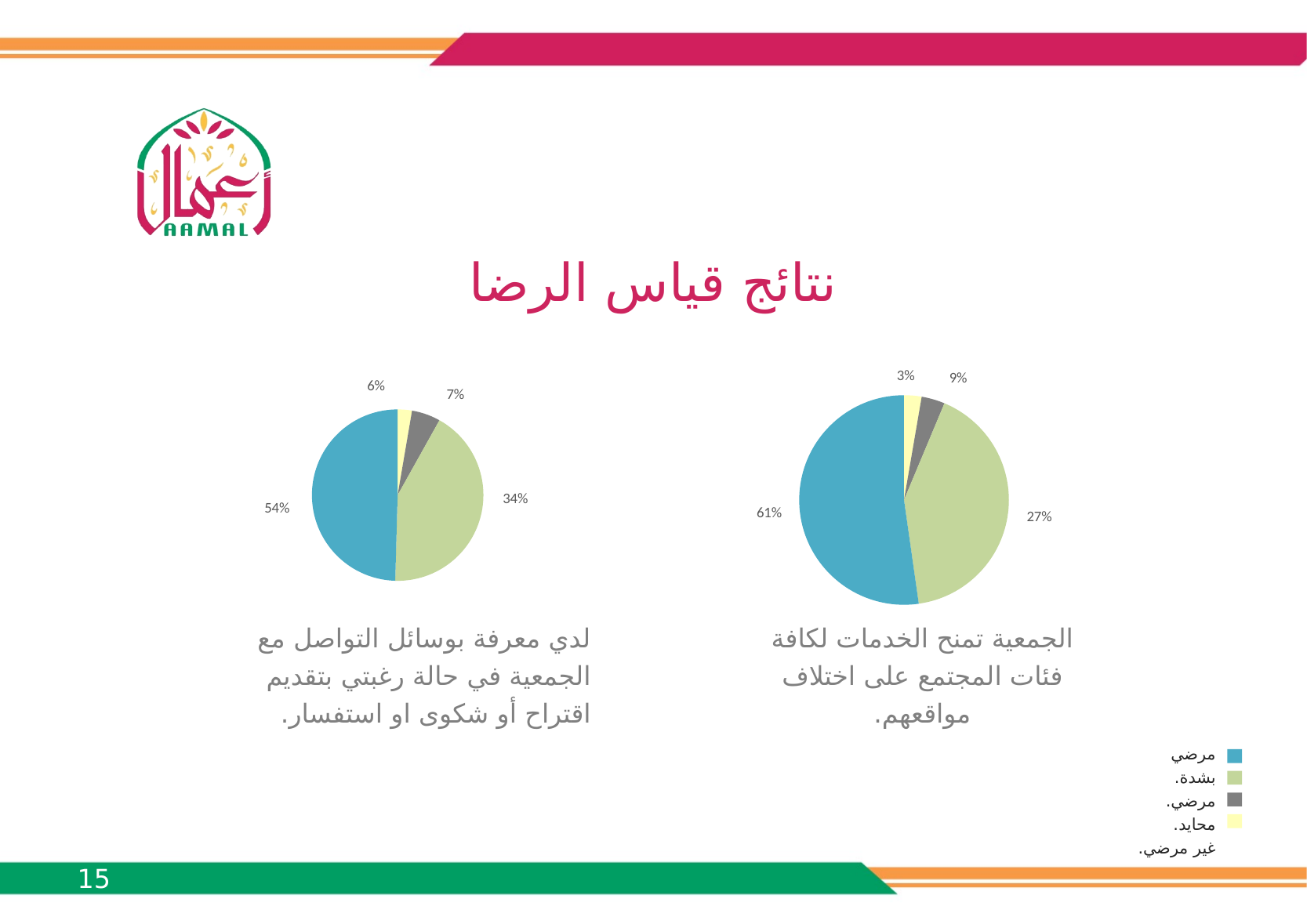
In the left pie chart (لدي معرفة بوسائل التواصل مع الجمعية), what is the largest slice's percentage? 54% In the right pie chart (الجمعية تمنح الخدمات لكافة فئات المجتمع), what percentage does the blue slice represent? 61% In the left pie chart (لدي معرفة بوسائل التواصل مع الجمعية), what is the difference between the blue slice and the green slice? 20% In the right pie chart (الجمعية تمنح الخدمات لكافة فئات المجتمع), what percentage does the green slice represent? 27% In the right pie chart (الجمعية تمنح الخدمات لكافة فئات المجتمع), what is the smallest slice's percentage? 3% In the right pie chart (الجمعية تمنح الخدمات لكافة فئات المجتمع), what is the difference between the blue slice and the green slice? 34% Which chart has the larger blue slice, the left pie chart or the right pie chart? The right pie chart In the left pie chart (لدي معرفة بوسائل التواصل مع الجمعية), what percentage does the blue slice represent? 54% What type of charts are shown on the slide? Pie charts In the left pie chart (لدي معرفة بوسائل التواصل مع الجمعية), what percentage does the grey slice represent? 7% How many pie charts are on the slide? 2 How many slices does each pie chart have? 4